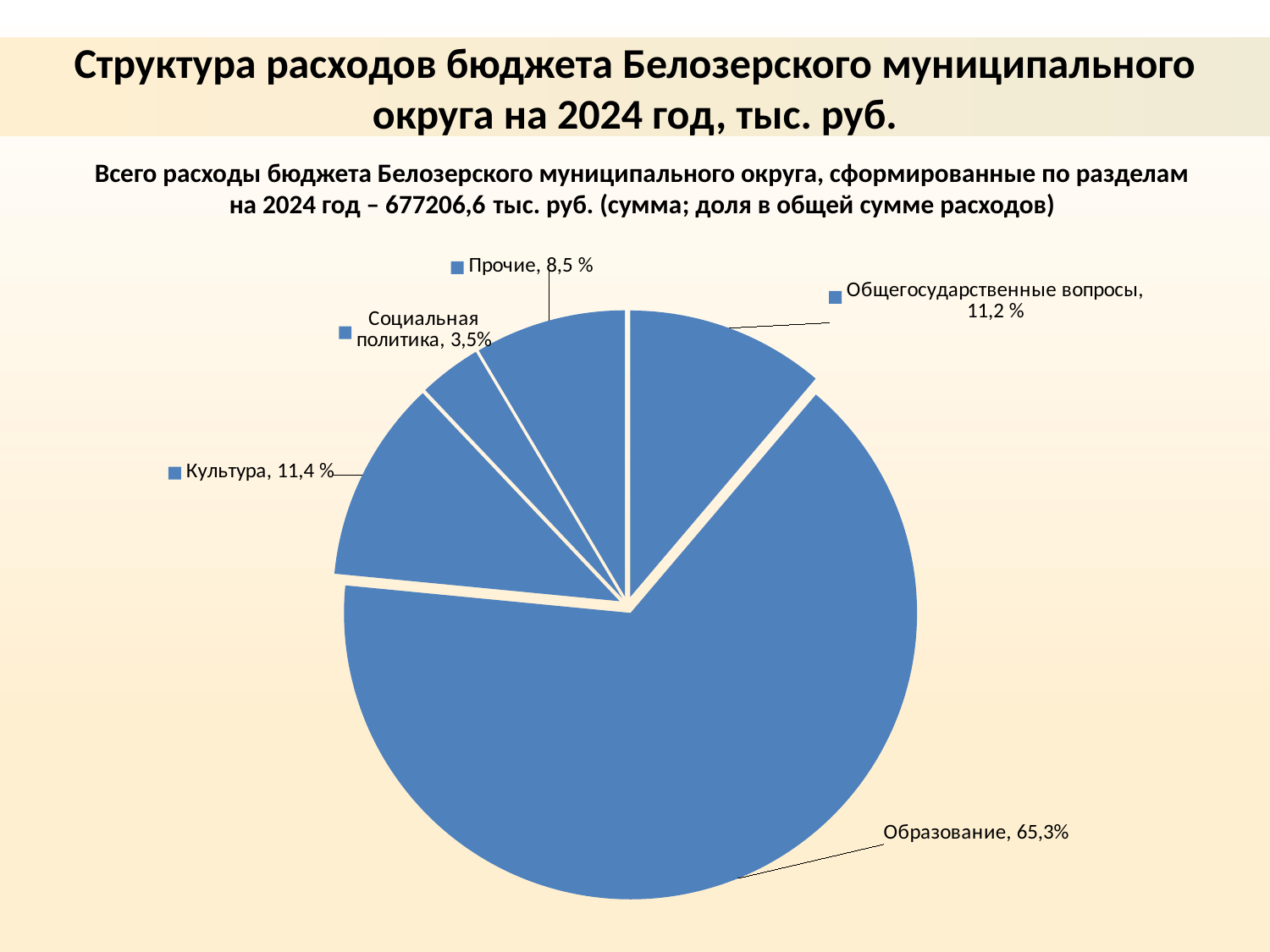
Which slice is larger, Прочие or Социальная политика? Прочие What share of the pie does Общегосударственные вопросы have? 11,2 % What kind of chart is shown on the slide? Pie chart Which slice is larger, Образование or Культура? Образование What share of the pie does Социальная политика have? 3,5% What share of the pie does Прочие have? 8,5 % Which category has the smallest slice of the pie? Социальная политика By how many percentage points does the share of Образование exceed the share of Культура? 53,9 What share of the pie does Образование have? 65,3% Which category has the largest slice of the pie? Образование What share of the pie does Культура have? 11,4 % How many categories are shown in the pie chart? 5